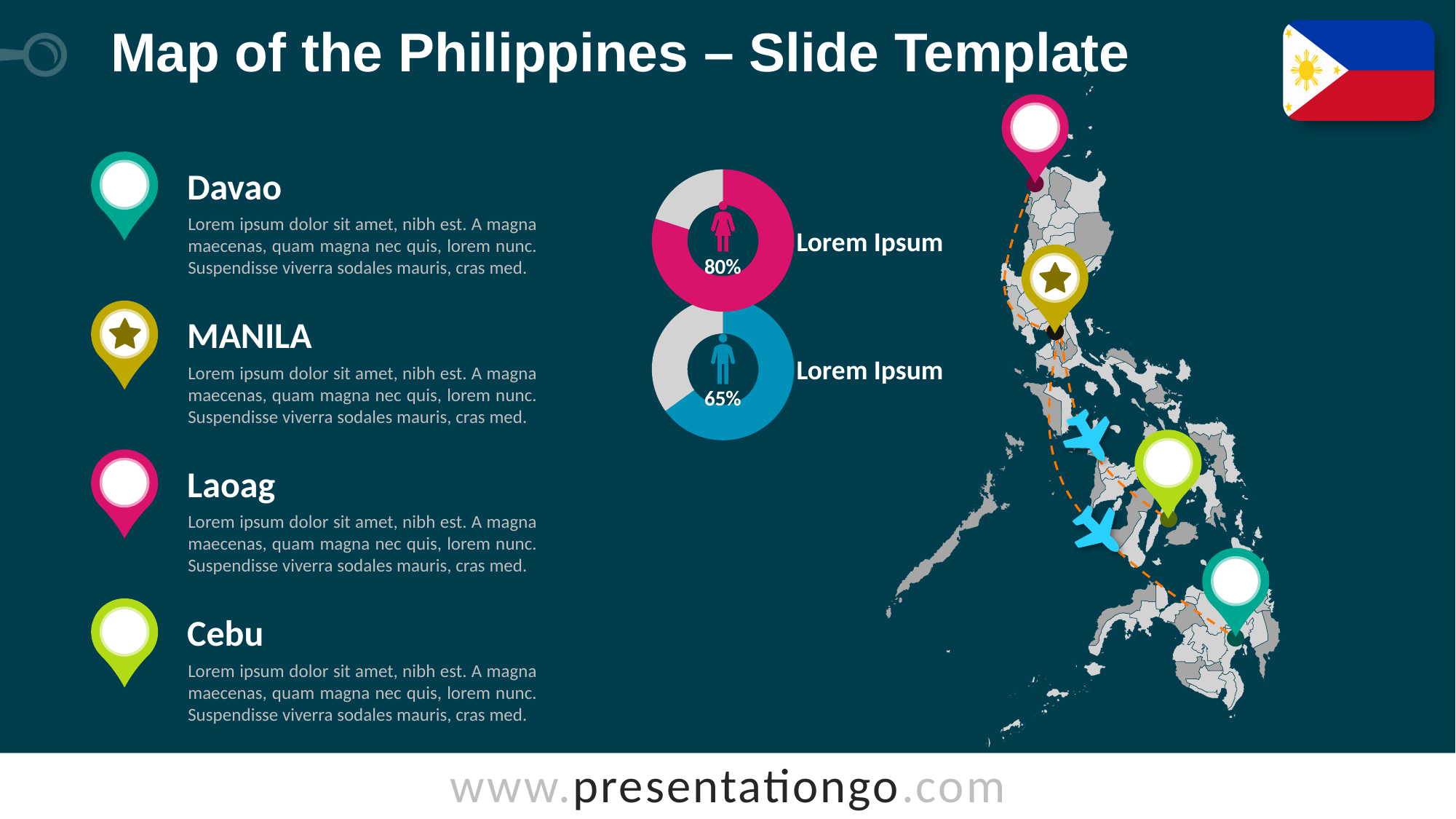
What colour is the filled portion of the donut chart showing 80%? pink What value is shown in the centre of the lower donut chart with the male icon? 65% What colour is the filled portion of the donut chart showing 65%? blue Which of the two donut charts shows the larger percentage, the upper pink one or the lower blue one? the upper pink one Is the value in the lower donut chart with the male icon greater or less than 70%? less What kind of chart is used to display the 80% and 65% values? donut chart What is the difference between the percentage in the upper donut chart and the percentage in the lower donut chart? 15% Is the value in the upper donut chart with the female icon greater or less than 75%? greater What share of the lower donut chart with the male icon is filled in blue? 65% How many donut charts are shown on the slide? 2 What value is shown in the centre of the upper donut chart with the female icon? 80% What share of the upper donut chart with the female icon is filled in pink? 80%